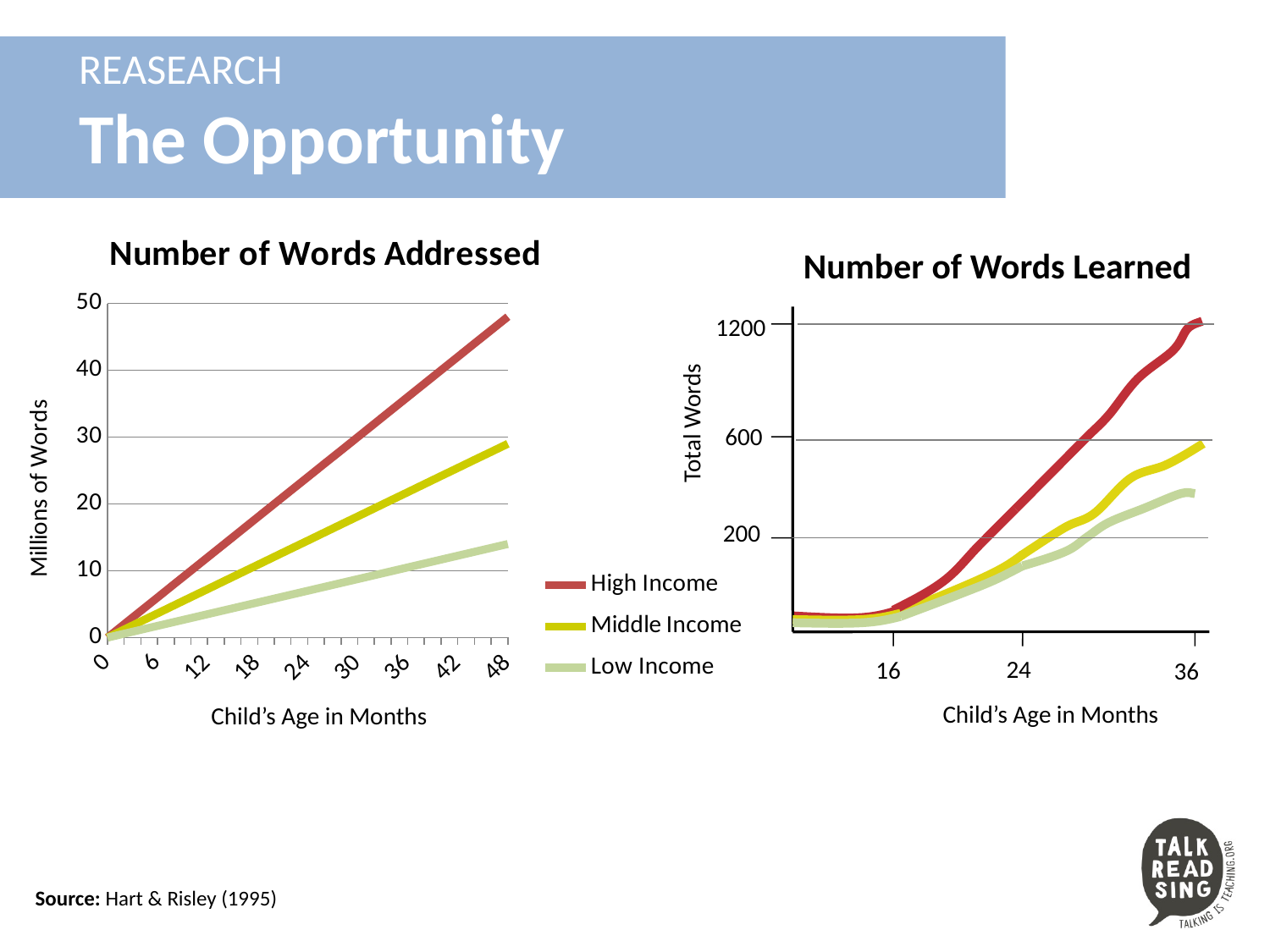
In the "Number of Words Learned" chart, do the values for High Income rise or fall as the child's age increases? rise In the "Number of Words Addressed" chart, which series is lowest at 48 months? Low Income In the "Number of Words Addressed" chart, is the value for Low Income at 48 months greater or less than 20? less What is the y-axis label of the "Number of Words Addressed" chart? Millions of Words In the "Number of Words Addressed" chart, is the value for Middle Income at 48 months greater or less than 20? greater In the "Number of Words Addressed" chart, is the value for High Income at 48 months greater or less than 40? greater What kind of chart is the "Number of Words Addressed" chart? line chart In the "Number of Words Learned" chart, which series is highest at 36 months? High Income In the "Number of Words Addressed" chart, which series is highest at 48 months? High Income What kind of chart is the "Number of Words Learned" chart? line chart How many series does the legend list? 3